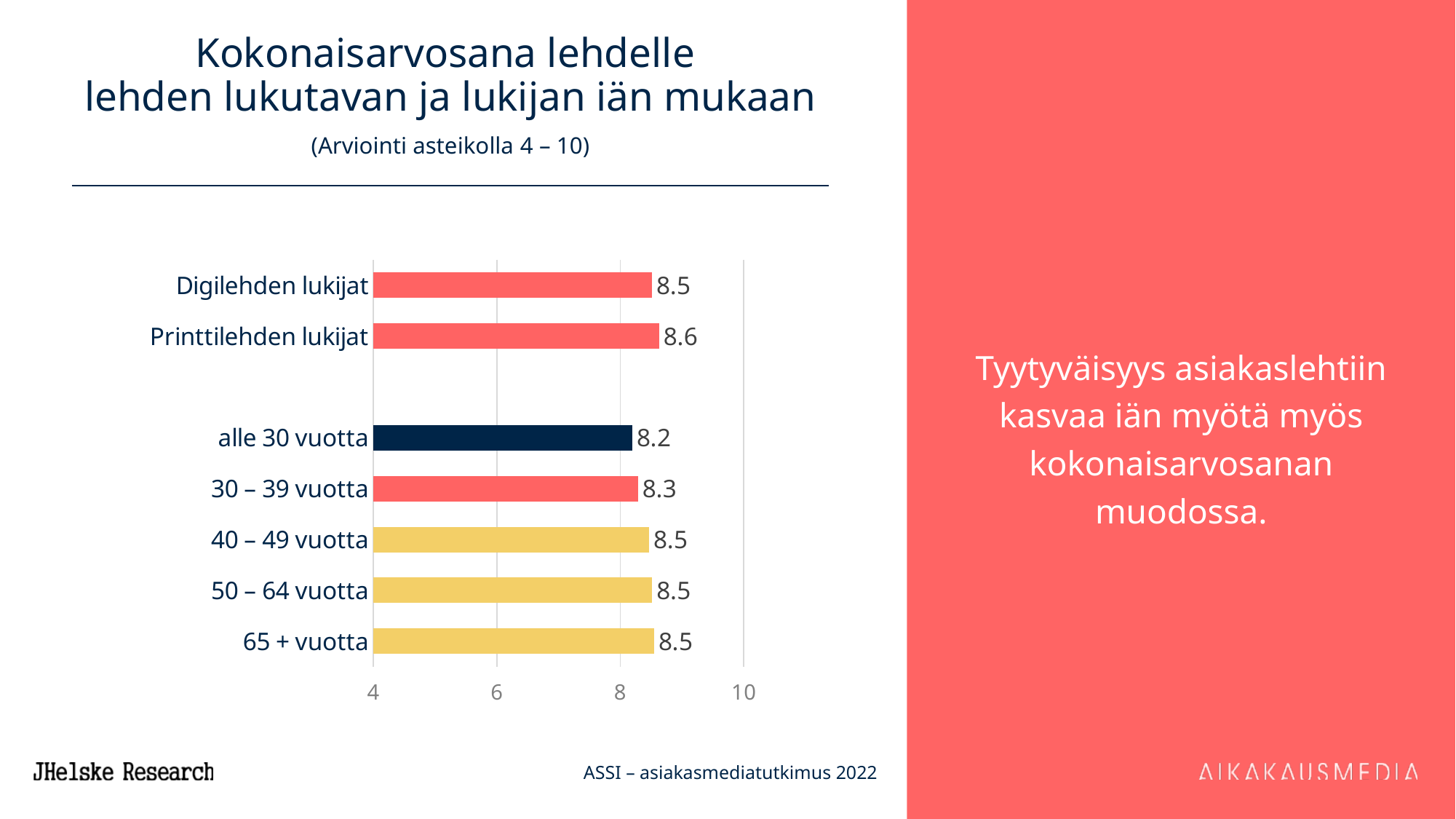
Is the value for alle 30 vuotta greater or less than 8? greater Which category has the highest value? Printtilehden lukijat What is the value for Digilehden lukijat? 8.5 Which category has the lowest value? alle 30 vuotta What is the value for 30 – 39 vuotta? 8.3 What is the rating scale stated in the chart subtitle? 4 – 10 What is the value for Printtilehden lukijat? 8.6 What is the value for alle 30 vuotta? 8.2 What kind of chart is shown on the slide? bar chart Which is larger, the value for Printtilehden lukijat or Digilehden lukijat? Printtilehden lukijat What is the difference between the values for Printtilehden lukijat and alle 30 vuotta? 0.4 How many categories are shown in the chart? 7